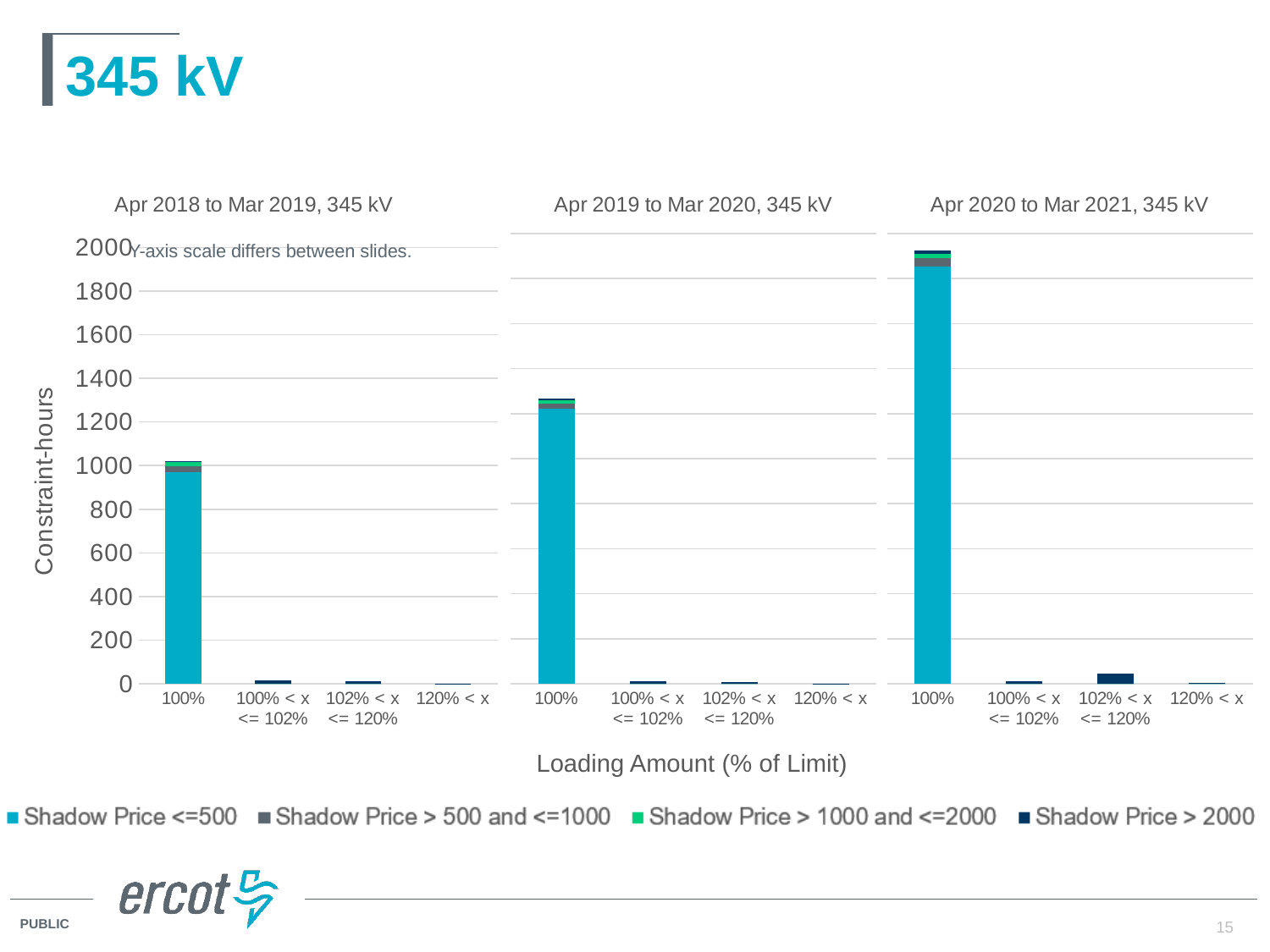
What is the y-axis title of the "Apr 2018 to Mar 2019, 345 kV" chart? Constraint-hours What kind of chart is the "Apr 2018 to Mar 2019, 345 kV" chart? Stacked bar chart In the "Apr 2019 to Mar 2020, 345 kV" chart, is the total value for the 100% category greater or less than 1200? greater In the "Apr 2020 to Mar 2021, 345 kV" chart, which is larger: the bar for 100% < x <= 102% or the bar for 102% < x <= 120%? 102% < x <= 120% In the "Apr 2018 to Mar 2019, 345 kV" chart, is the total value for the 100% category greater or less than 800? greater In the "Apr 2020 to Mar 2021, 345 kV" chart, is the total value for the 100% category greater or less than 1800? greater What is the x-axis title shared by the charts on this slide? Loading Amount (% of Limit) In the "Apr 2018 to Mar 2019, 345 kV" chart, which loading amount category has the highest total constraint-hours? 100% How many series does the legend list for the charts on this slide? 4 Which chart has the taller 100% bar: "Apr 2018 to Mar 2019, 345 kV" or "Apr 2020 to Mar 2021, 345 kV"? Apr 2020 to Mar 2021, 345 kV In the "Apr 2020 to Mar 2021, 345 kV" chart, which loading amount category has the highest total constraint-hours? 100% In the "Apr 2019 to Mar 2020, 345 kV" chart, how many loading amount categories are shown on the x axis? 4